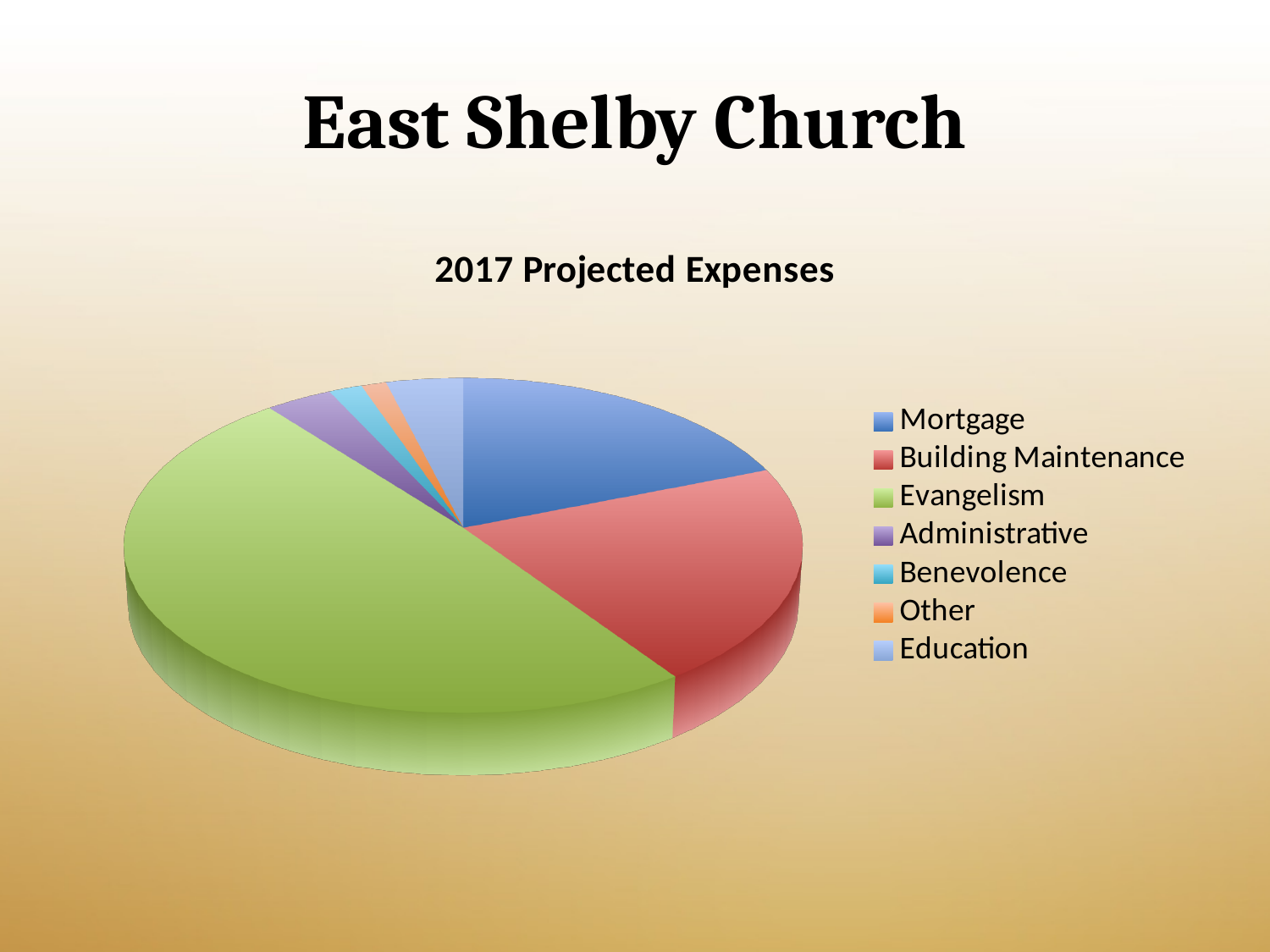
Which is larger, the slice for Mortgage or the slice for Education? Mortgage Which is larger, the slice for Evangelism or the slice for Mortgage? Evangelism What is the title of the chart? 2017 Projected Expenses Which category is shown in green on the pie chart? Evangelism Which is larger, the slice for Building Maintenance or the slice for Benevolence? Building Maintenance Which category has the largest slice of the pie? Evangelism How many categories does the pie chart show? 7 What kind of chart is shown on the slide? pie chart